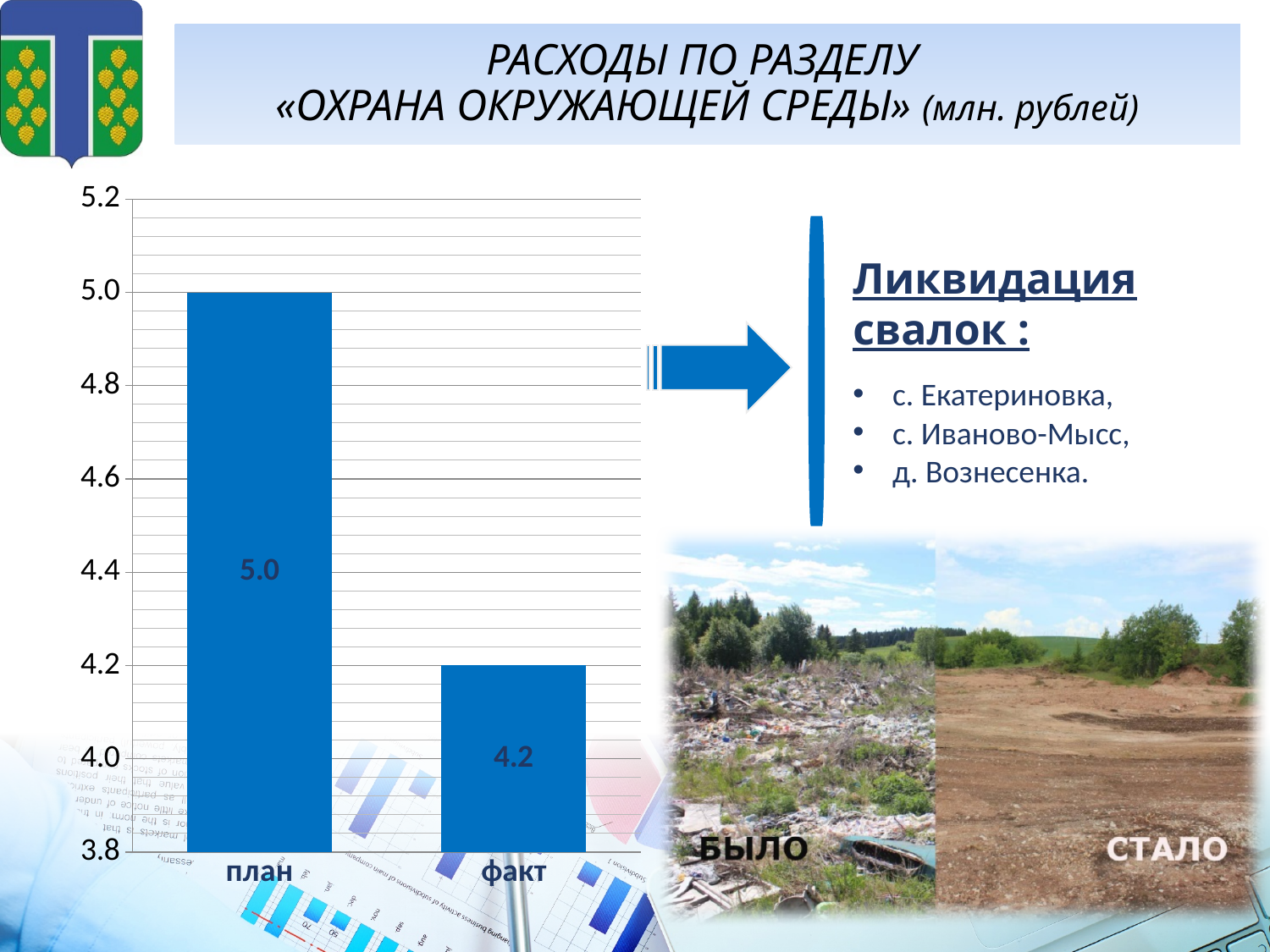
What is the difference between the план and факт values? 0.8 How many categories are shown on the chart? 2 Which is larger, план or факт? план What is the value for план? 5.0 What kind of chart is shown on the slide? bar chart Is the value for факт greater or less than 4.4? less Do the values rise or fall from план to факт? fall What is the value for факт? 4.2 Which category has the lowest value? факт In what units are the values on the chart expressed, according to the slide title? млн. рублей Is the value for план greater or less than 4.8? greater Which category has the highest value? план